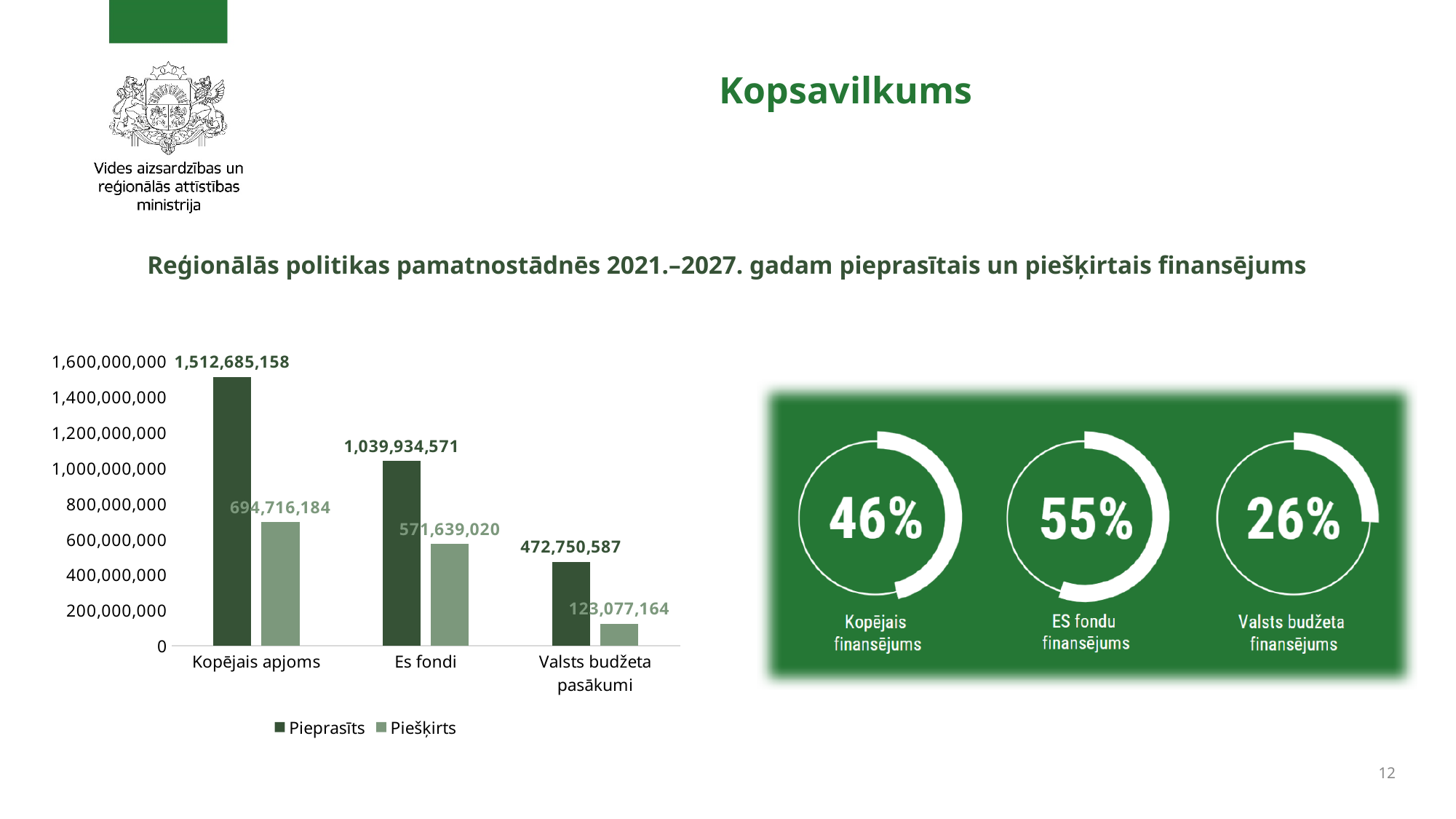
Which category has the highest Piešķirts value? Kopējais apjoms Which category has the lowest Pieprasīts value? Valsts budžeta pasākumi What is the Piešķirts value for Es fondi? 571,639,020 What is the Pieprasīts value for Kopējais apjoms? 1,512,685,158 Which is larger: the Piešķirts value for Kopējais apjoms or the Pieprasīts value for Valsts budžeta pasākumi? Piešķirts value for Kopējais apjoms How many series does the legend of the bar chart list? 2 What is the difference between the Pieprasīts and Piešķirts values for Valsts budžeta pasākumi? 349,673,423 What is the Piešķirts value for Valsts budžeta pasākumi? 123,077,164 How many categories are shown on the x axis of the bar chart? 3 What is the difference between the Pieprasīts and Piešķirts values for Es fondi? 468,295,551 What are the two legend entries of the bar chart? Pieprasīts and Piešķirts What type of chart is shown on the slide? Bar chart